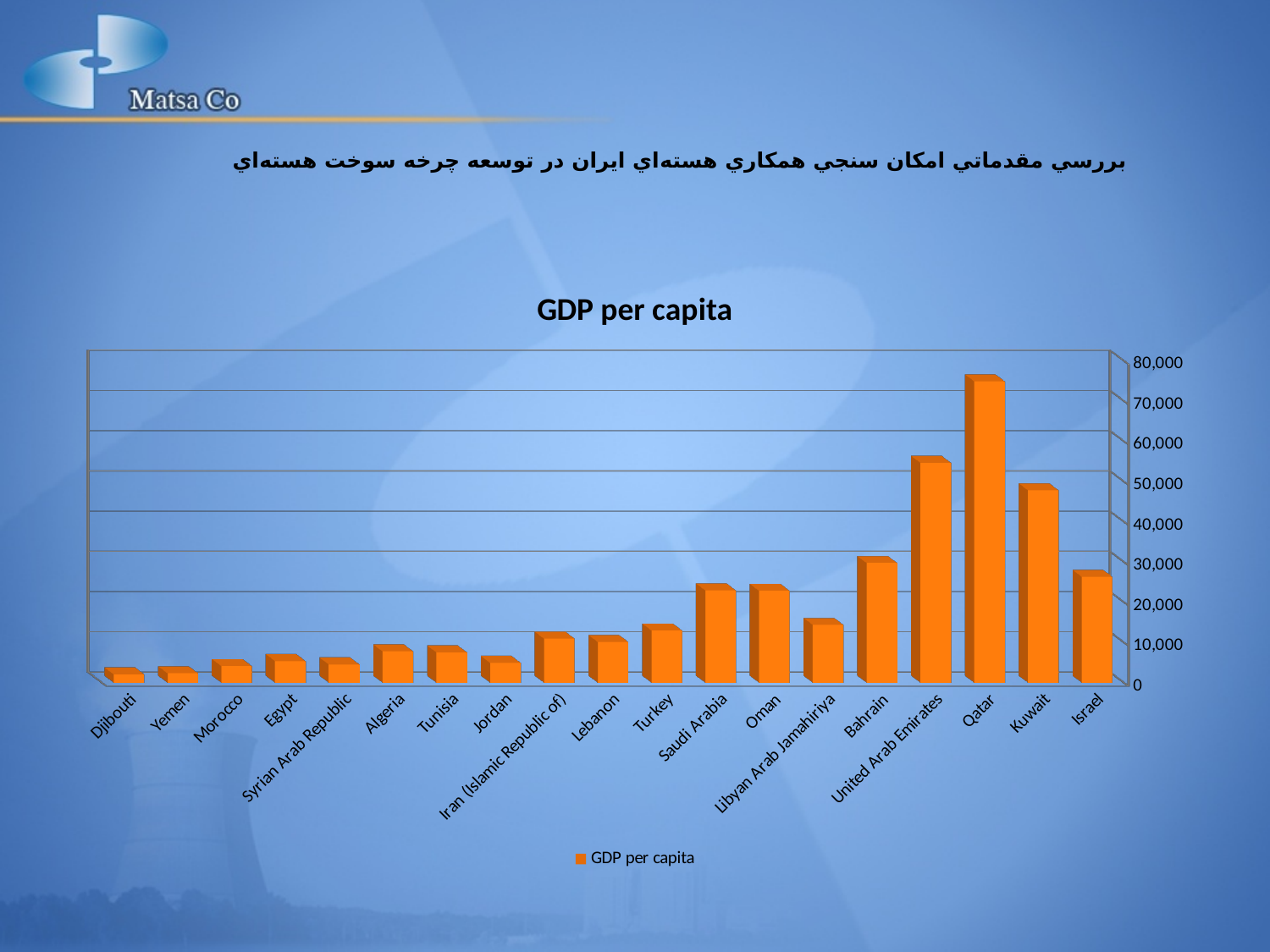
Which country has the lowest GDP per capita in the chart? Djibouti Which has a higher GDP per capita, Saudi Arabia or Turkey? Saudi Arabia What is the title of the chart? GDP per capita How many series does the legend list? 1 How many countries are shown on the x axis of the chart? 19 Which has a higher GDP per capita, Kuwait or Israel? Kuwait Is the value for Qatar greater or less than 70,000? greater Is the value for Yemen greater or less than 10,000? less Is the value for United Arab Emirates greater or less than 50,000? greater Which country has the highest GDP per capita in the chart? Qatar What kind of chart is shown on the slide? bar chart